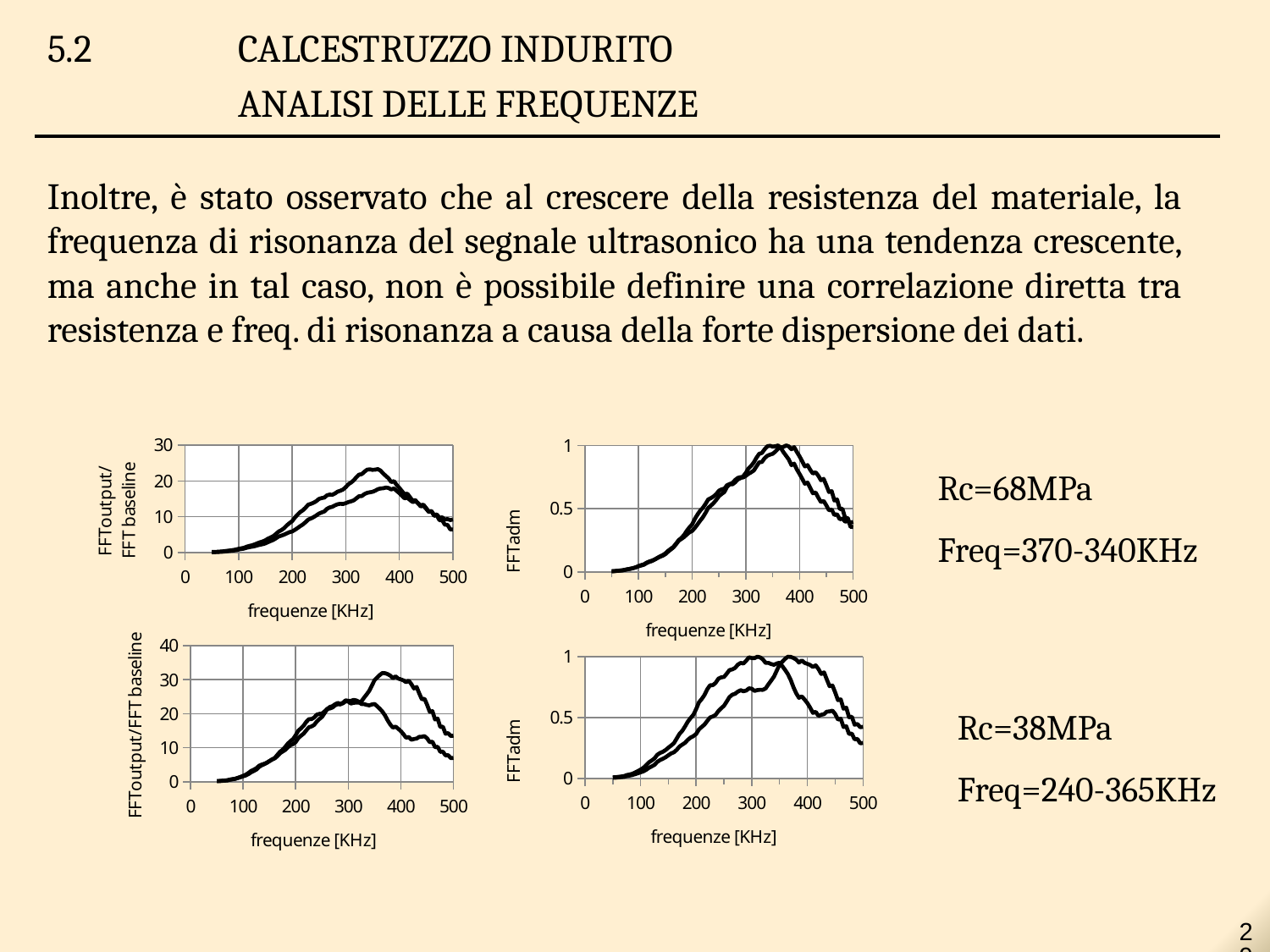
What is the y-axis label of the top-right chart? FFTadm In the top-left chart, are the values of both lines at 500 KHz greater or less than 10? less How many lines are plotted in the bottom-left chart? 2 In the top-right chart, are the values of both lines at 500 KHz greater or less than 0.5? less What is the highest value shown on the y-axis of the bottom-left chart? 40 In the bottom-left chart, is the peak value of the lower line greater or less than 30? less In the bottom-right chart, do the values rise or fall between 100 KHz and 300 KHz? rise What kind of chart is the top-left chart on the slide? line chart How many lines are plotted in the top-right chart? 2 What is the x-axis label of the bottom-right chart? frequenze [KHz]